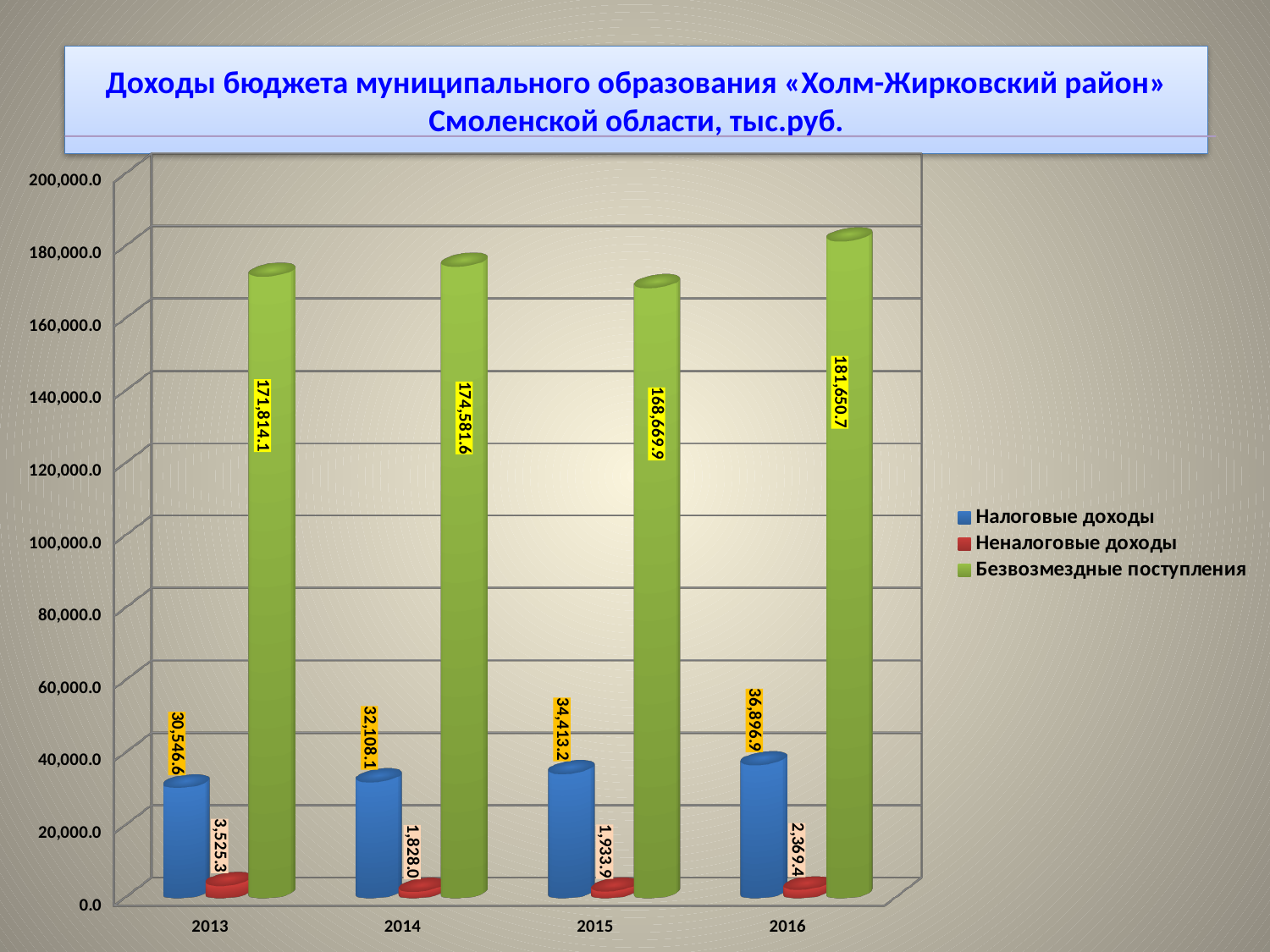
How many series does the legend list? 3 What is the value of Безвозмездные поступления for 2016? 181,650.7 What is the value of Налоговые доходы for 2013? 30,546.6 What kind of chart is shown on the slide? bar chart What is the difference between Налоговые доходы in 2016 and in 2015? 2,483.7 In which year is Неналоговые доходы the lowest? 2014 Is the value of Безвозмездные поступления for 2015 greater or less than 160,000.0? greater What is the value of Неналоговые доходы for 2014? 1,828.0 Which is larger: Безвозмездные поступления in 2014 or in 2015? 2014 How many years are shown on the x axis? 4 In which year is Безвозмездные поступления the highest? 2016 Do the values of Налоговые доходы rise or fall from 2013 to 2016? rise